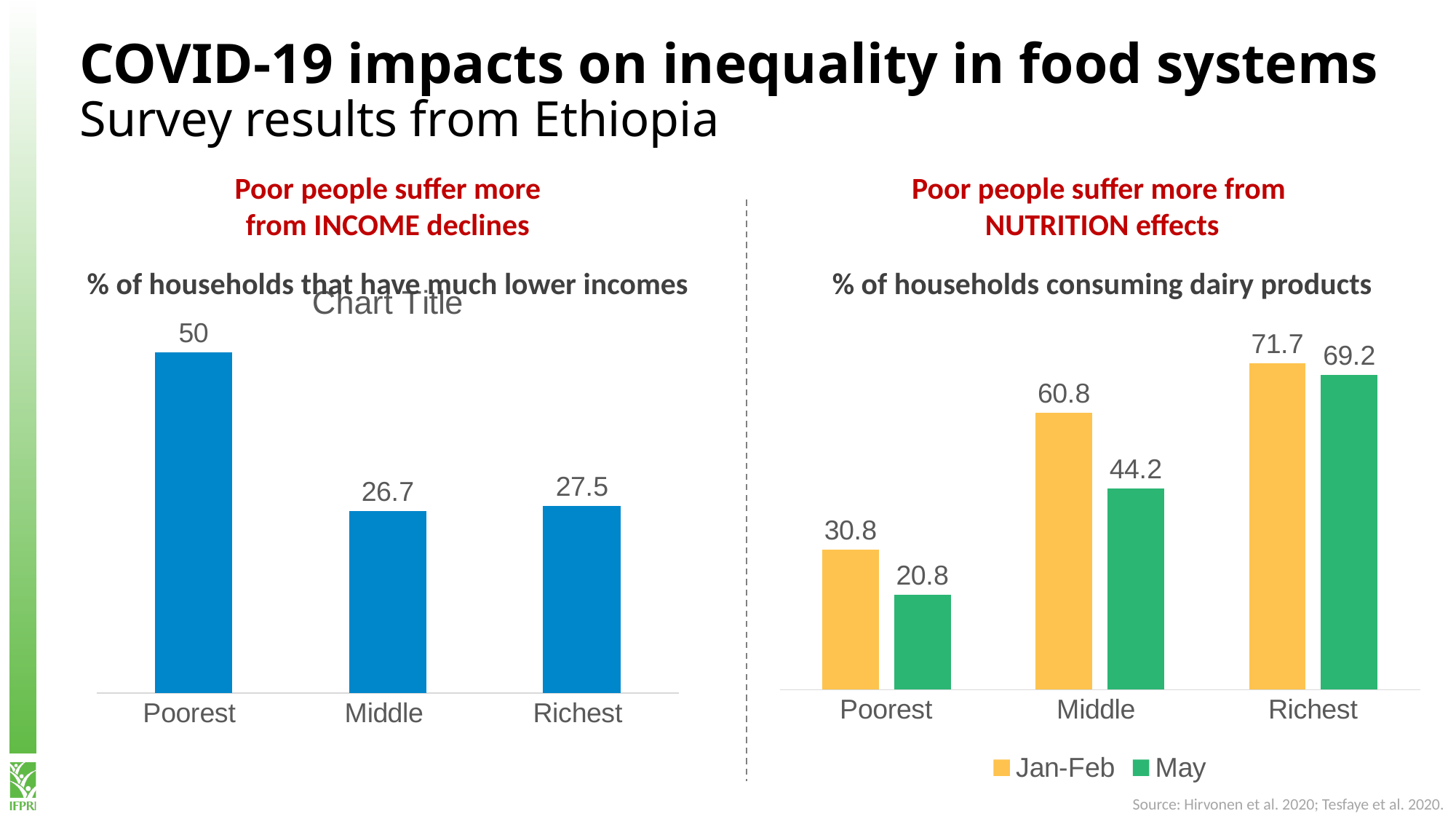
In the left chart (% of households that have much lower incomes), how many categories are shown? 3 In the right chart (% of households consuming dairy products), what is the May value for Middle? 44.2 In the left chart (% of households that have much lower incomes), what is the difference between the Poorest and Richest values? 22.5 In the right chart (% of households consuming dairy products), what is the Jan-Feb value for Richest? 71.7 How many series does the legend of the right chart (% of households consuming dairy products) list? 2 In the left chart (% of households that have much lower incomes), what is the value for Poorest? 50 In the right chart (% of households consuming dairy products), do the Jan-Feb values rise or fall from Poorest to Richest? Rise In the right chart (% of households consuming dairy products), which category has the lowest May value? Poorest In the right chart (% of households consuming dairy products), is the Jan-Feb value for Poorest larger or smaller than the May value for Poorest? Larger In the left chart (% of households that have much lower incomes), which category has the lowest value? Middle What kind of chart is the left chart (% of households that have much lower incomes)? Bar chart In the right chart (% of households consuming dairy products), what is the difference between the Jan-Feb and May values for Middle? 16.6